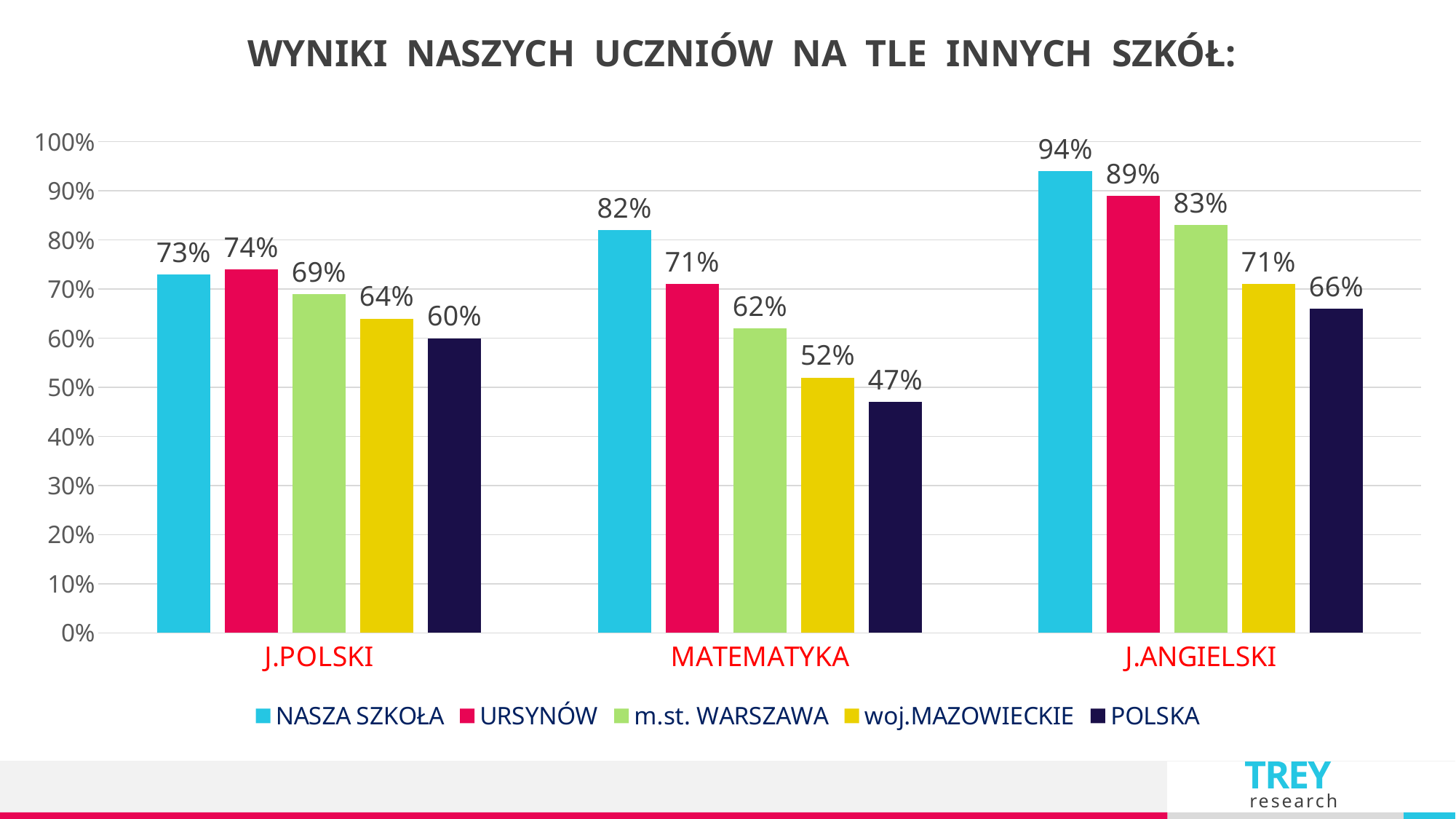
How many categories are shown on the x axis? 3 What is the value for NASZA SZKOŁA in MATEMATYKA? 82% How many series does the legend list? 5 Which series has the highest value in J.ANGIELSKI? NASZA SZKOŁA What is the difference between NASZA SZKOŁA and POLSKA in MATEMATYKA? 35% Which series has the lowest value in MATEMATYKA? POLSKA What is the value for woj.MAZOWIECKIE in J.POLSKI? 64% Is the value for m.st. WARSZAWA in J.ANGIELSKI greater or less than 80%? greater What is the title of the chart? WYNIKI NASZYCH UCZNIÓW NA TLE INNYCH SZKÓŁ: What kind of chart is shown on the slide? Bar chart What is the value for POLSKA in J.ANGIELSKI? 66% Which is larger in J.POLSKI: NASZA SZKOŁA or URSYNÓW? URSYNÓW